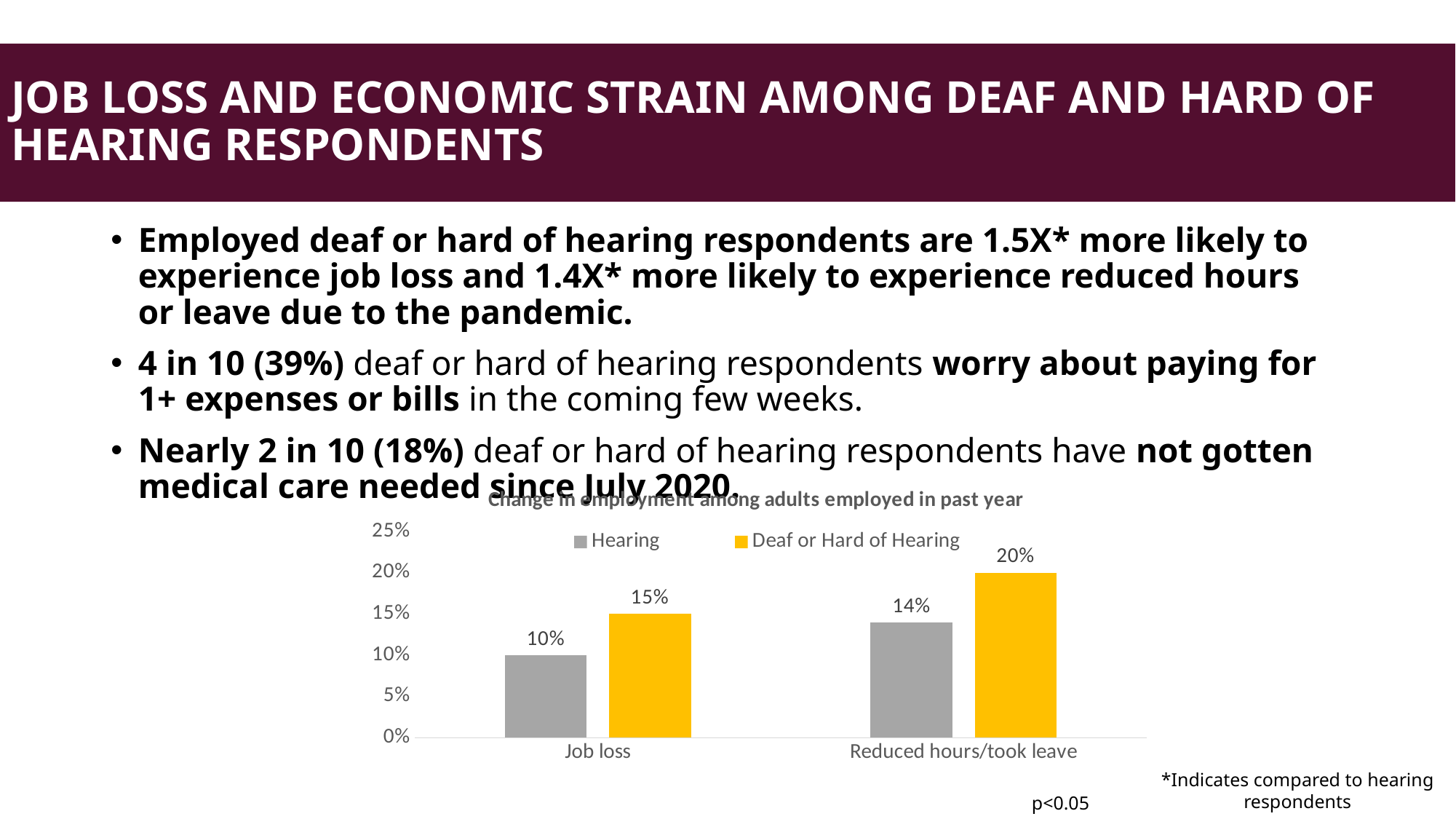
What is the value for Hearing respondents for Reduced hours/took leave? 14% Which bar in the chart has the highest value? Deaf or Hard of Hearing, Reduced hours/took leave What is the value for Deaf or Hard of Hearing respondents for Job loss? 15% What is the value for Deaf or Hard of Hearing respondents for Reduced hours/took leave? 20% How many series does the chart legend list? 2 For Reduced hours/took leave, which group has the larger value, Hearing or Deaf or Hard of Hearing? Deaf or Hard of Hearing What is the difference between the Deaf or Hard of Hearing and Hearing values for Job loss? 5% What is the difference between the Deaf or Hard of Hearing and Hearing values for Reduced hours/took leave? 6% How many categories are shown on the x axis of the chart? 2 Which bar in the chart has the lowest value? Hearing, Job loss What kind of chart is shown on the slide? Bar chart What is the value for Hearing respondents for Job loss? 10%